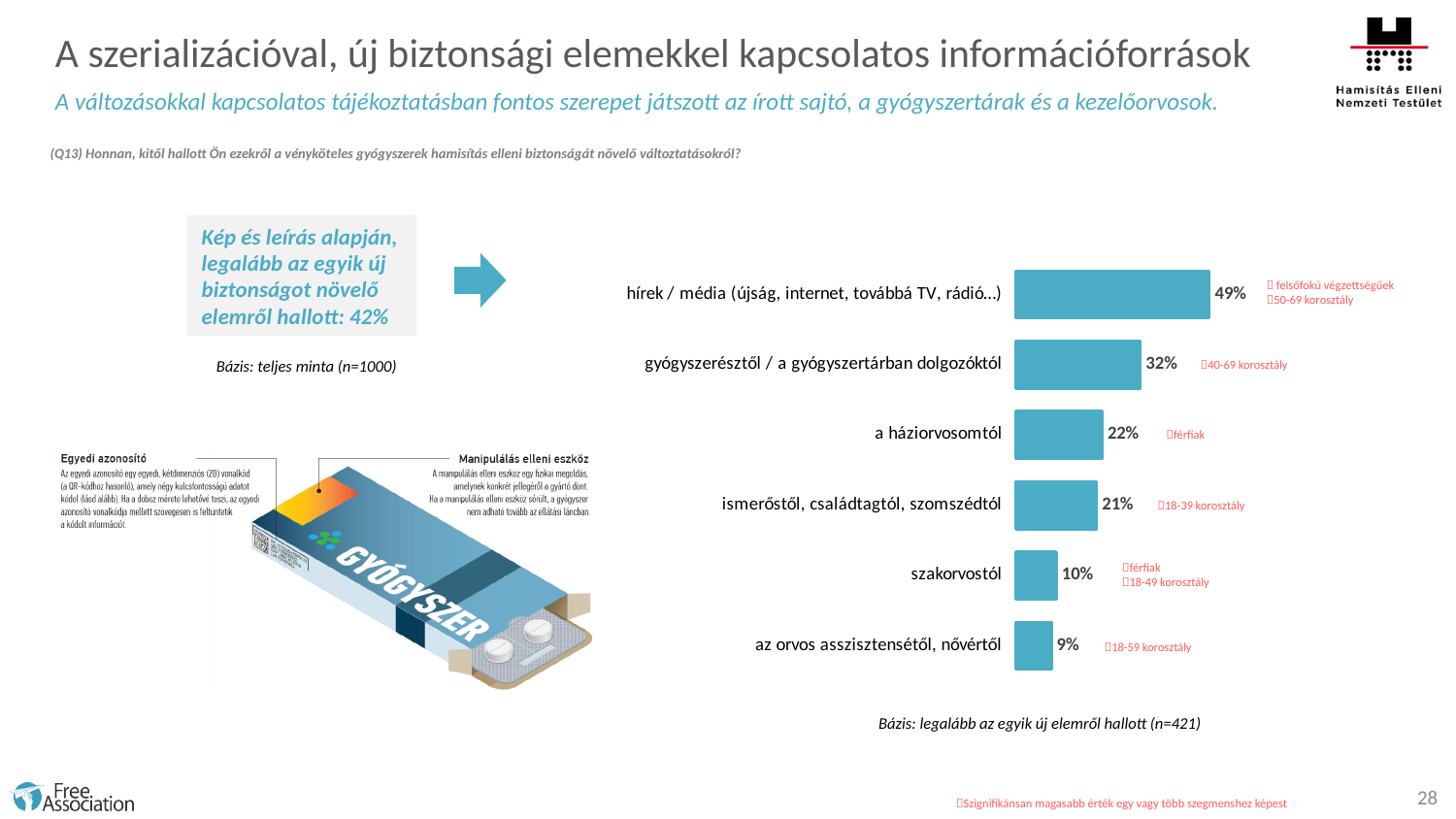
What is the value for "szakorvostól"? 10% What is the difference between the values for "hírek / média" and "gyógyszerésztől / a gyógyszertárban dolgozóktól"? 17% Which category has the lowest value? az orvos asszisztensétől, nővértől What is the value for "gyógyszerésztől / a gyógyszertárban dolgozóktól"? 32% How many categories are shown in the bar chart? 6 What is the base (bázis) stated below the bar chart? legalább az egyik új elemről hallott (n=421) Which is larger, the value for "a háziorvosomtól" or the value for "ismerőstől, családtagtól, szomszédtól"? a háziorvosomtól What kind of chart is shown on the slide? bar chart What is the difference between the values for "a háziorvosomtól" and "szakorvostól"? 12% What percentage is given in the blue box on the left for those who heard about at least one new security element? 42% What is the value for "hírek / média (újság, internet, továbbá TV, rádió…)"? 49% Which category has the highest value? hírek / média (újság, internet, továbbá TV, rádió…)